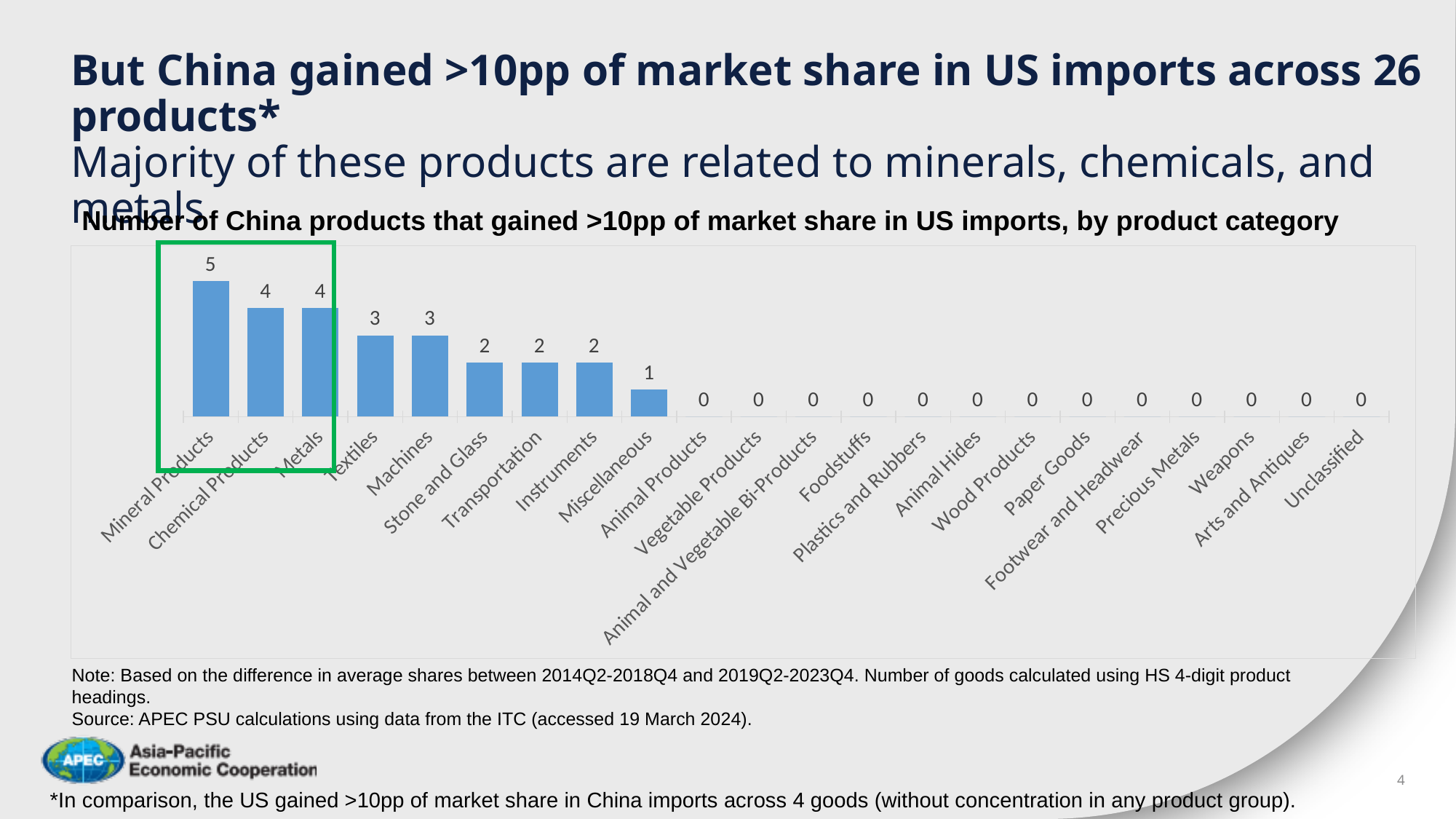
Which is larger, the value for Chemical Products or the value for Stone and Glass? Chemical Products What is the value for Miscellaneous? 1 Do the values rise or fall moving from left to right along the x axis? Fall What is the title of the chart? Number of China products that gained >10pp of market share in US imports, by product category What is the value for Textiles? 3 Which product category has the highest value? Mineral Products How many product categories are shown on the x axis? 22 What kind of chart is shown? Bar chart What is the value for Mineral Products? 5 What is the difference between the values for Mineral Products and Machines? 2 What is the value for Transportation? 2 How many product categories have a value of 0? 13